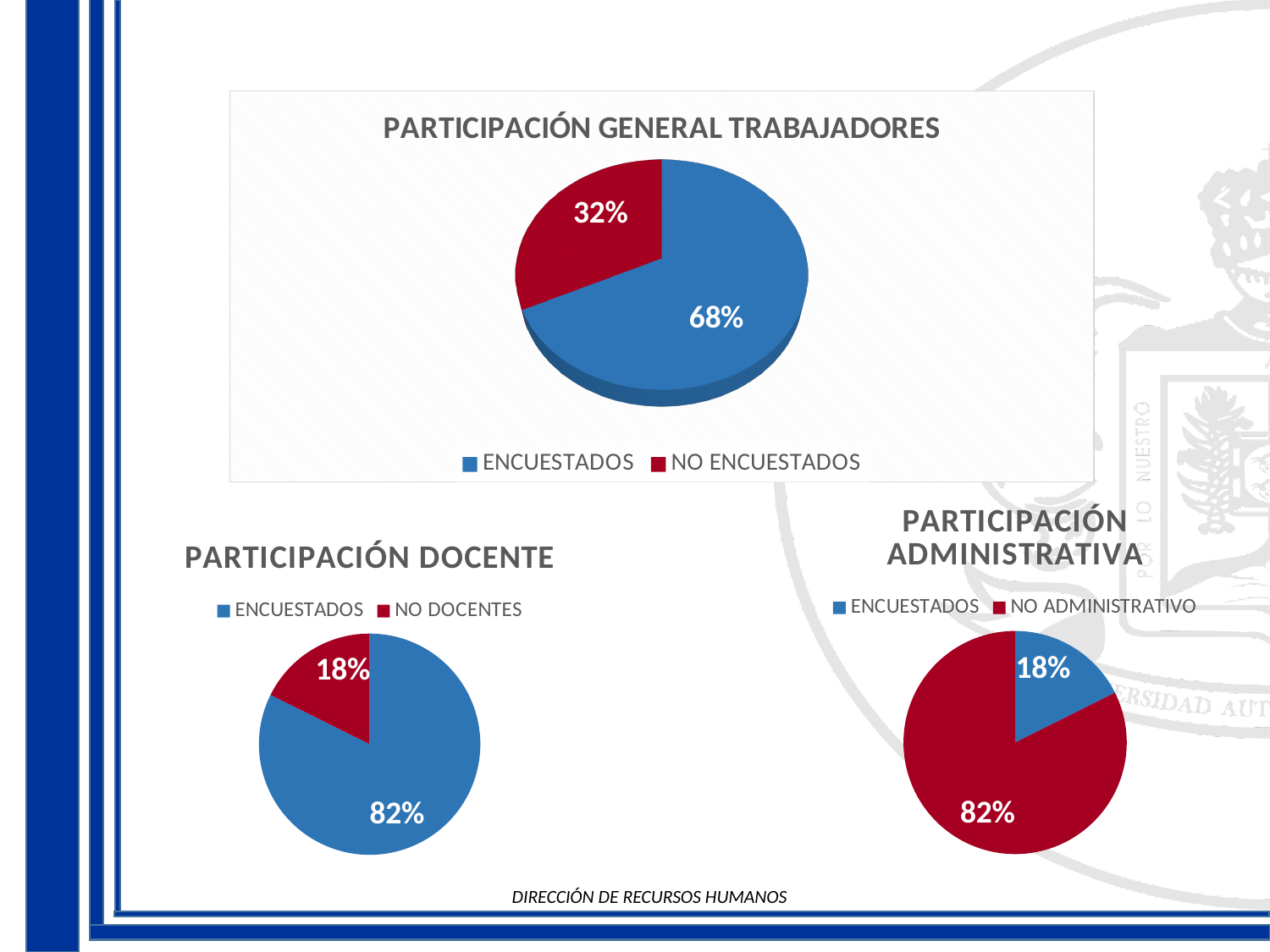
What kind of chart is the PARTICIPACIÓN DOCENTE chart? Pie chart In the PARTICIPACIÓN GENERAL TRABAJADORES chart, which slice is the largest? ENCUESTADOS How many slices does the PARTICIPACIÓN GENERAL TRABAJADORES pie chart have? 2 In the PARTICIPACIÓN DOCENTE chart, which slice is the smallest? NO DOCENTES In the PARTICIPACIÓN ADMINISTRATIVA chart, which is larger, ENCUESTADOS or NO ADMINISTRATIVO? NO ADMINISTRATIVO In the PARTICIPACIÓN ADMINISTRATIVA chart, what share of the pie is ENCUESTADOS? 18% In the PARTICIPACIÓN GENERAL TRABAJADORES chart, what share of the pie is NO ENCUESTADOS? 32% In the PARTICIPACIÓN GENERAL TRABAJADORES chart, what share of the pie is ENCUESTADOS? 68% In the PARTICIPACIÓN GENERAL TRABAJADORES chart, what is the difference between the ENCUESTADOS and NO ENCUESTADOS shares? 36%